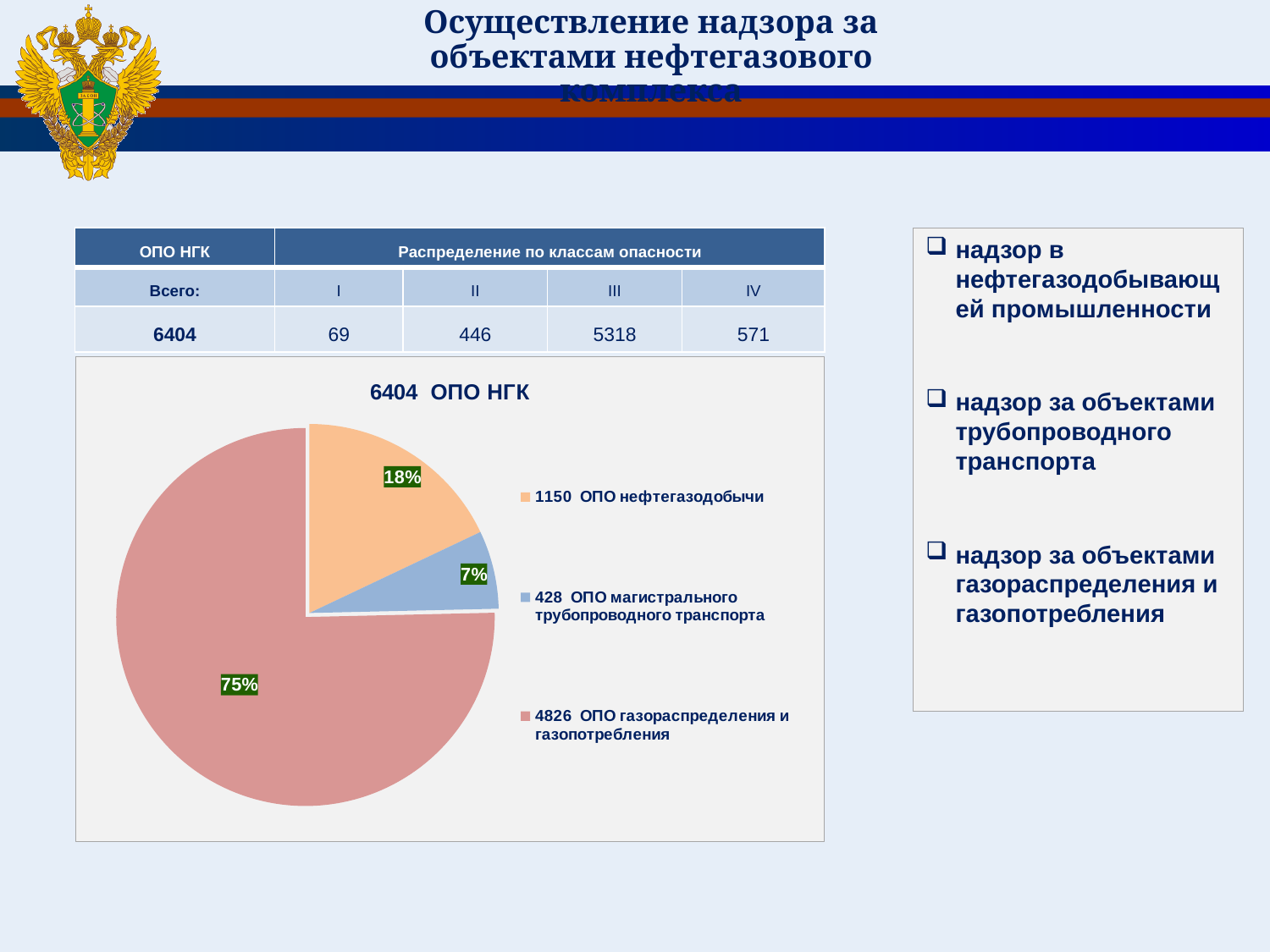
What share of the pie does ОПО газораспределения и газопотребления take? 75% According to the legend, how many ОПО магистрального трубопроводного транспорта are there? 428 What is the difference in percentage points between the share for ОПО газораспределения и газопотребления and the share for ОПО нефтегазодобычи? 57 Which category has the largest slice in the pie chart? ОПО газораспределения и газопотребления What kind of chart is shown on the slide? pie chart According to the legend, how many ОПО нефтегазодобычи are there? 1150 How many slices does the pie chart have? 3 What share of the pie does ОПО магистрального трубопроводного транспорта take? 7% Which is larger: the share for ОПО нефтегазодобычи or the share for ОПО магистрального трубопроводного транспорта? ОПО нефтегазодобычи Which category has the smallest slice in the pie chart? ОПО магистрального трубопроводного транспорта What share of the pie does ОПО нефтегазодобычи take? 18% What is the title of the pie chart? 6404 ОПО НГК